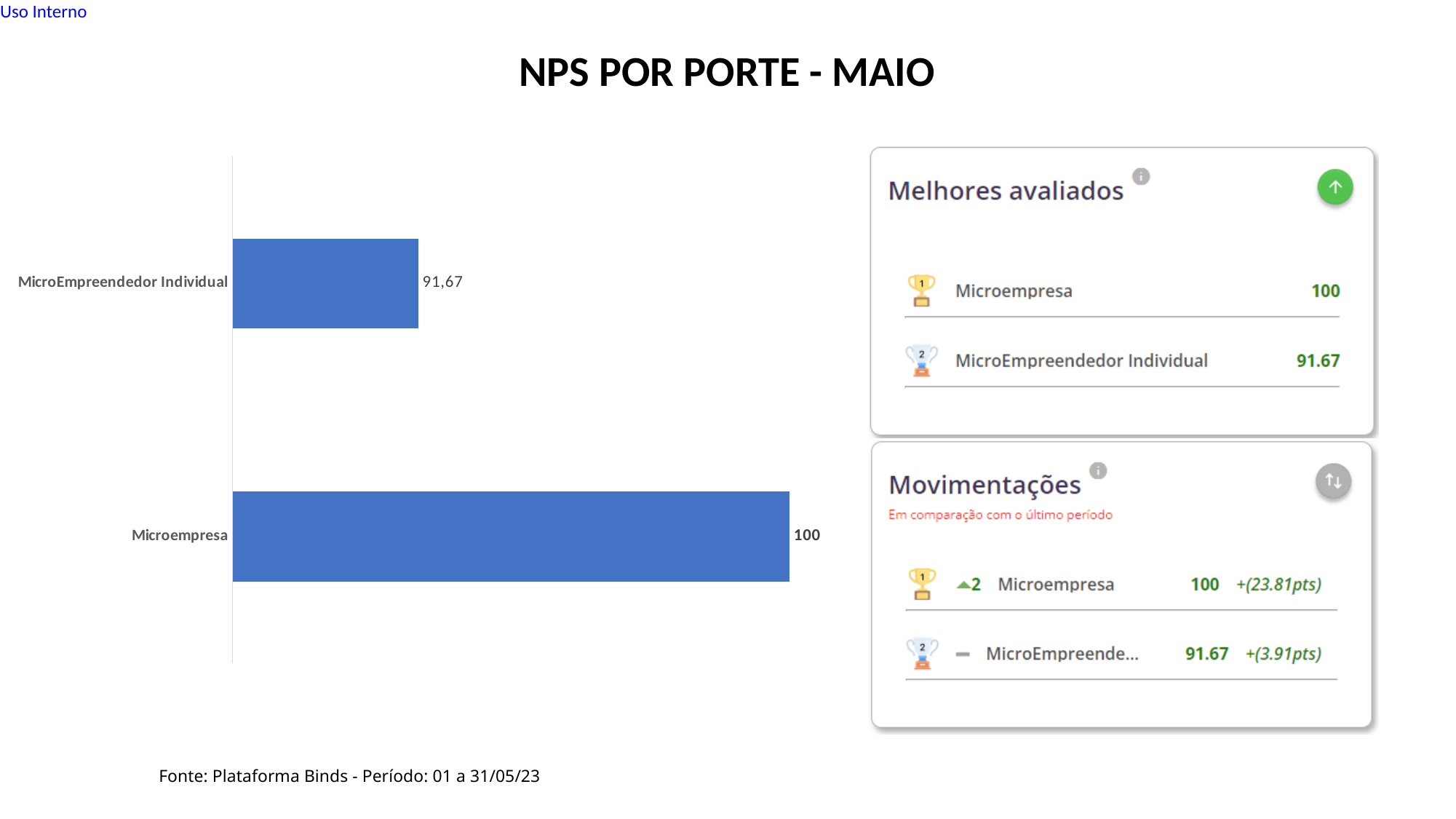
What is the value for MicroEmpreendedor Individual in the bar chart? 91,67 Which category has the highest value in the bar chart? Microempresa Which is larger, the value for Microempresa or the value for MicroEmpreendedor Individual? Microempresa What is the difference between the values for Microempresa and MicroEmpreendedor Individual? 8,33 What is the title of the slide containing the chart? NPS POR PORTE - MAIO What colour are the bars in the chart? Blue What kind of chart is shown on the slide? Bar chart Which category has the lowest value in the bar chart? MicroEmpreendedor Individual What is the value for Microempresa in the bar chart? 100 How many categories are shown in the bar chart? 2